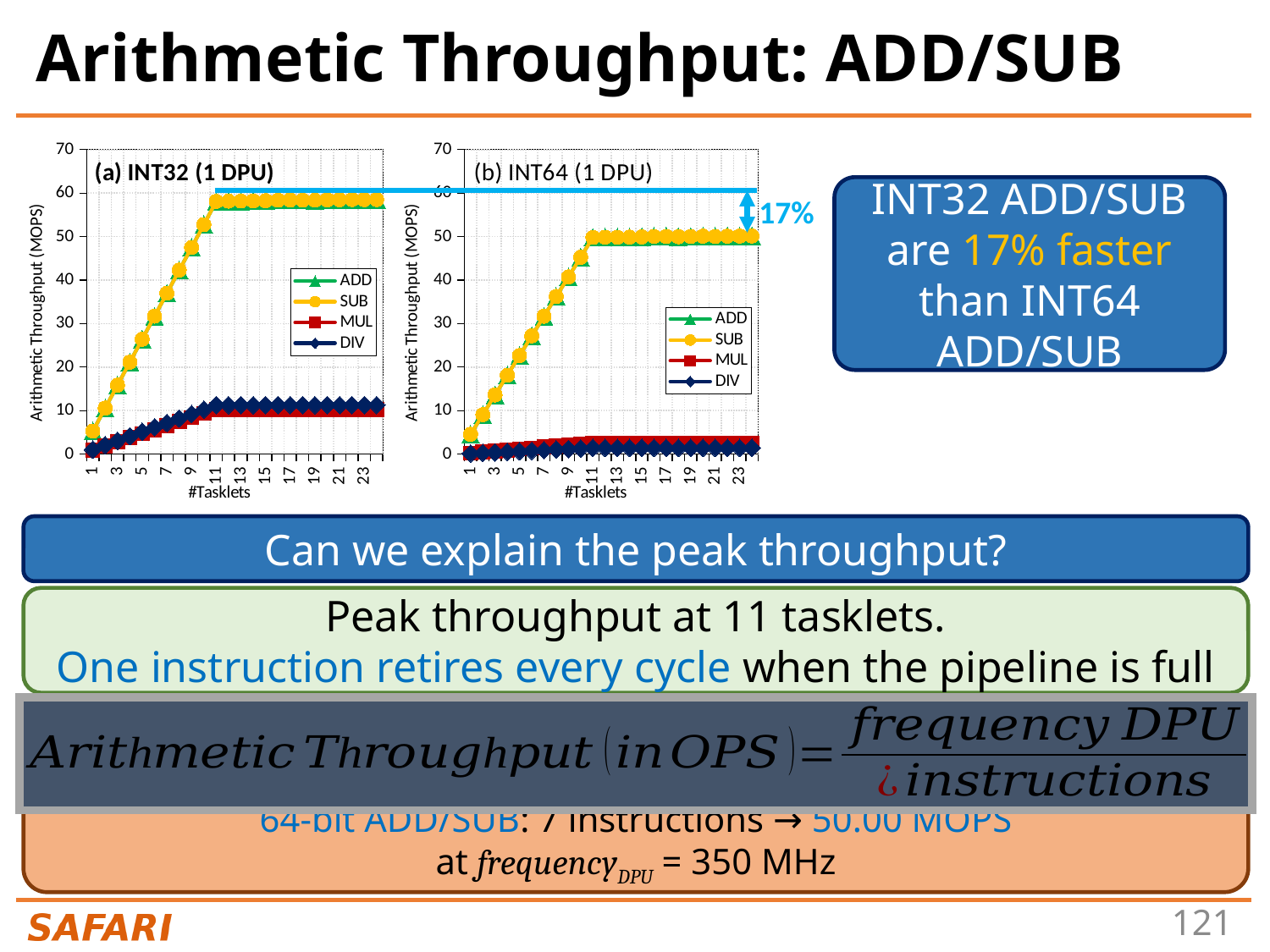
What is the label of the x axis on the (a) INT32 (1 DPU) chart? #Tasklets In the (a) INT32 (1 DPU) chart, which series has the lowest throughput at 23 tasklets? MUL How many series does the legend of the (b) INT64 (1 DPU) chart list? 4 In the (a) INT32 (1 DPU) chart, which is larger at 23 tasklets: the ADD throughput or the MUL throughput? ADD In the (a) INT32 (1 DPU) chart, is the ADD throughput at 23 tasklets greater or less than 50 MOPS? greater In the (b) INT64 (1 DPU) chart, is the DIV throughput at 23 tasklets greater or less than 10 MOPS? less What kind of chart is the (a) INT32 (1 DPU) chart? line chart In the (b) INT64 (1 DPU) chart, how does the ADD throughput change as the number of tasklets increases from 1 to 11? It rises Comparing the two charts, which has the higher peak ADD throughput: (a) INT32 (1 DPU) or (b) INT64 (1 DPU)? (a) INT32 (1 DPU) What percentage difference is annotated between the peak throughputs of the two charts? 17% In the (b) INT64 (1 DPU) chart, is the SUB throughput at 23 tasklets greater or less than 60 MOPS? less